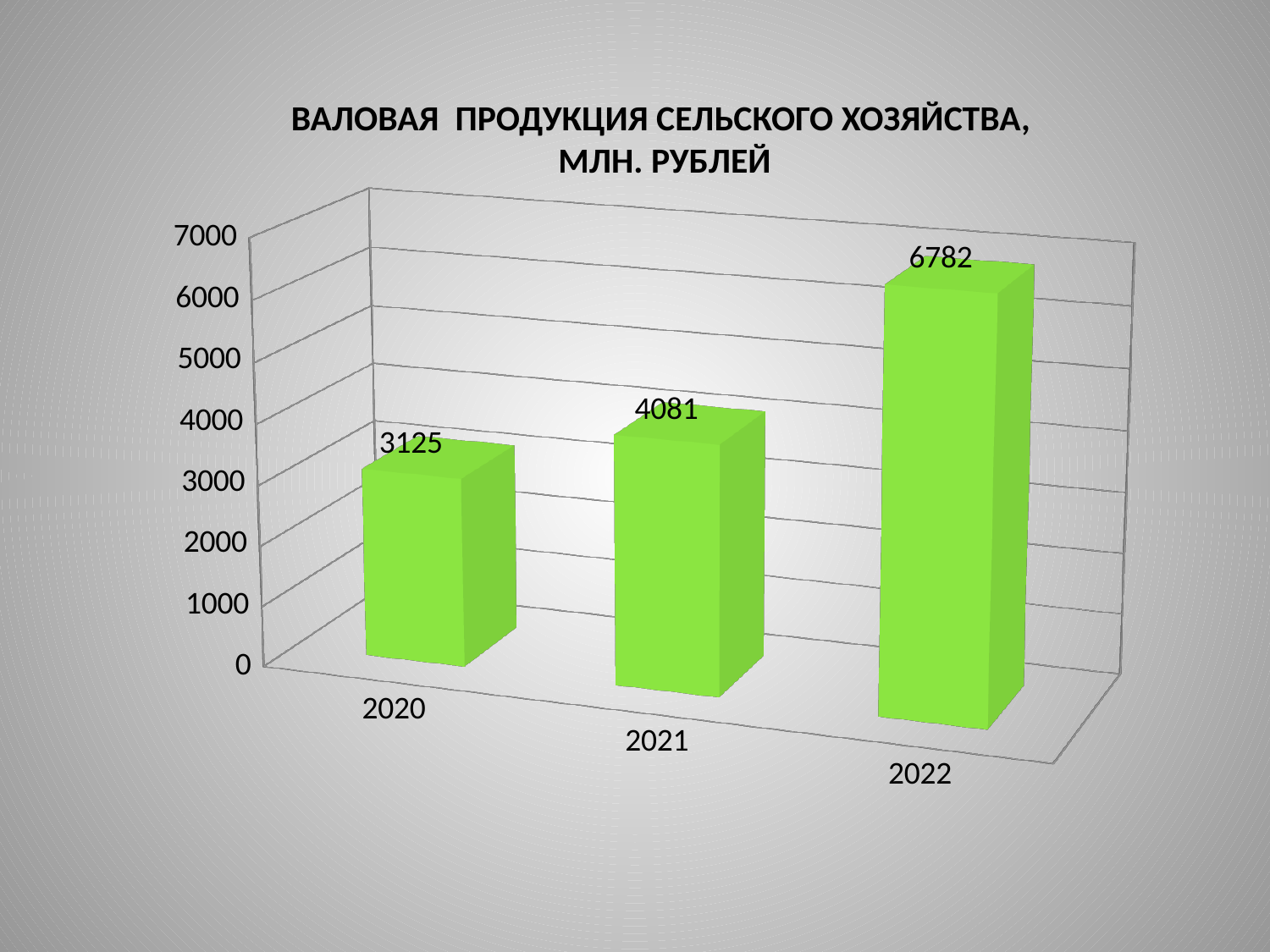
How many years are shown on the chart? 3 Which year has the lowest value? 2020 Is the value for 2022 greater or less than 6000? greater What is the value for 2020? 3125 What is the value for 2022? 6782 Which year has the highest value? 2022 What is the difference between the values for 2022 and 2021? 2701 What is the difference between the values for 2021 and 2020? 956 What kind of chart is shown on the slide? bar chart Which is larger, the value for 2020 or the value for 2021? 2021 Do the values rise or fall from 2020 to 2022? rise What is the value for 2021? 4081